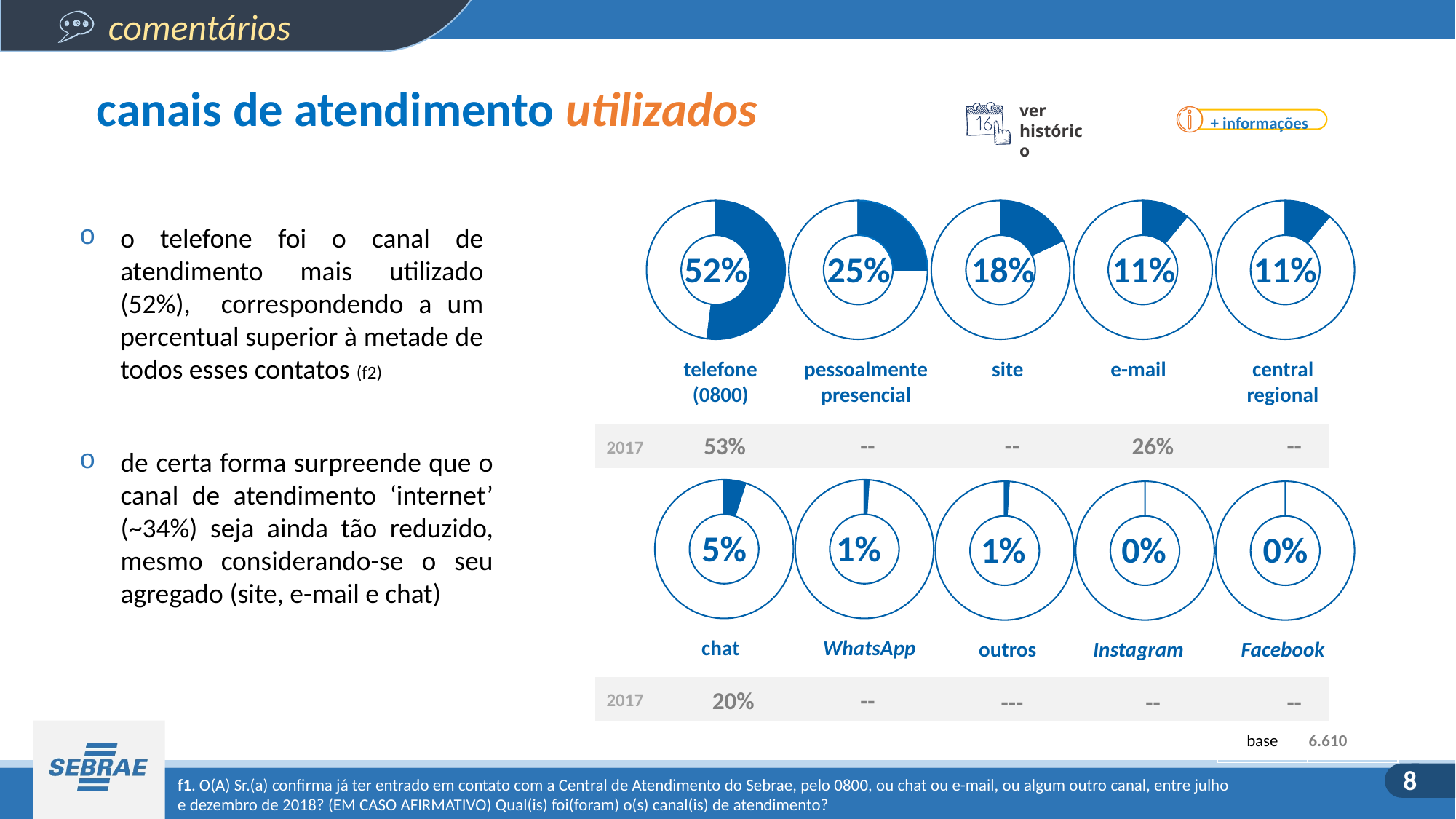
What is the difference between the percentages shown for telefone (0800) and pessoalmente presencial? 27% What percentage is shown in the donut chart for chat? 5% What percentage is shown in the donut chart for site? 18% What kind of charts are used to show the channel percentages? donut (pie) charts What percentage is shown in the donut chart for pessoalmente presencial? 25% What was the 2017 value shown below the telefone (0800) donut chart? 53% Which has a larger percentage, site or e-mail? site What was the 2017 value shown below the e-mail donut chart? 26% Which channel has the highest percentage among the donut charts? telefone (0800) What percentage is shown in the donut charts for Instagram and Facebook? 0% What percentage is shown in the donut chart for telefone (0800)? 52% How many donut charts are shown on the slide? 10